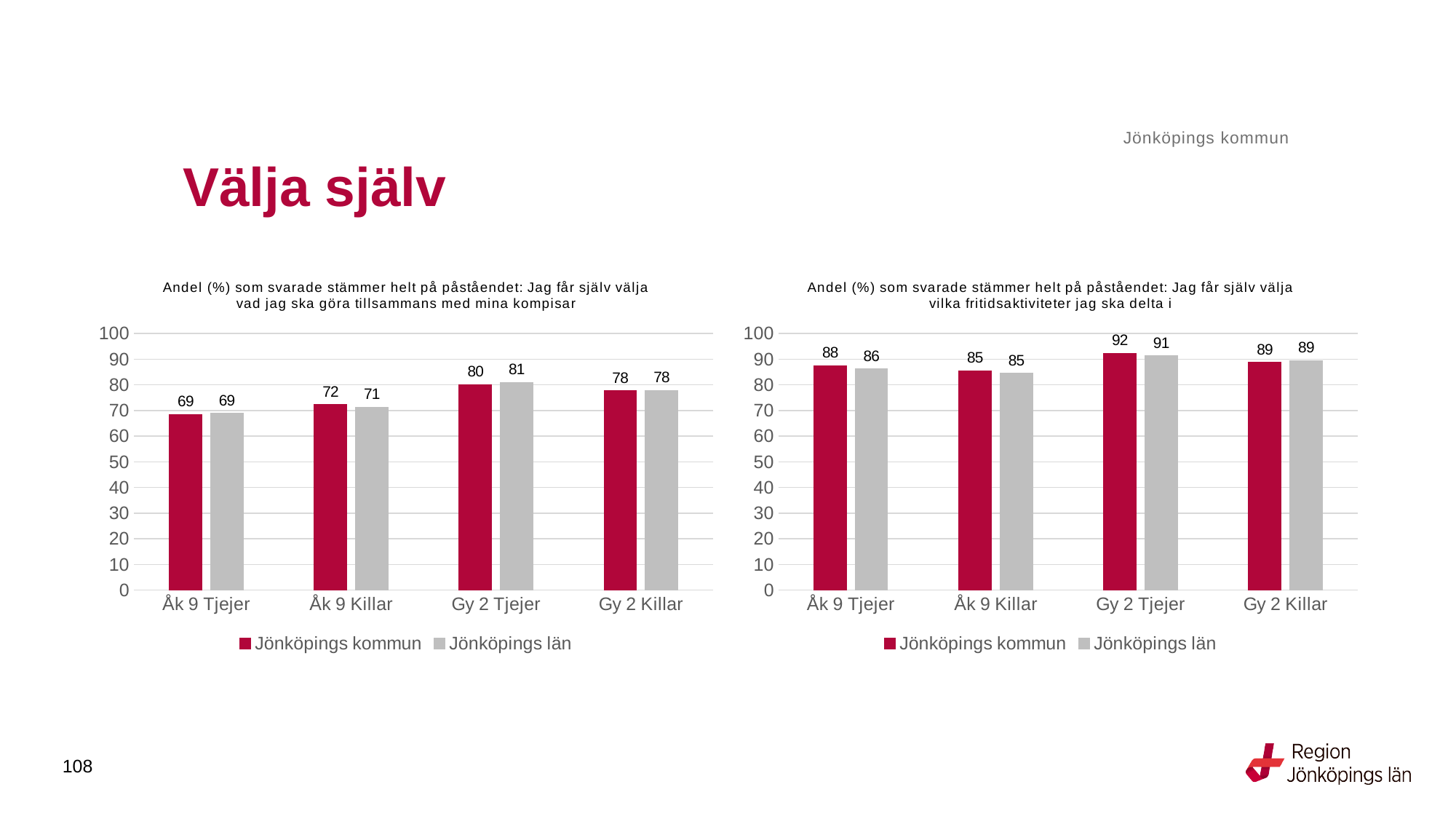
In the left chart, is the value for Jönköpings län for Åk 9 Tjejer greater or less than 80? less In the right chart (about choosing leisure activities), what is the value for Jönköpings län for Gy 2 Tjejer? 91 In the left chart, which colour represents Jönköpings kommun? red In the right chart, which category has the lowest value for Jönköpings län? Åk 9 Killar What kind of chart is the left chart? bar chart In the left chart, which category has the highest value for Jönköpings kommun? Gy 2 Tjejer In the right chart, which is larger for Gy 2 Tjejer: Jönköpings kommun or Jönköpings län? Jönköpings kommun In the right chart, what is the difference between the Jönköpings kommun and Jönköpings län values for Åk 9 Tjejer? 2 In the left chart (about choosing what to do with friends), what is the value for Jönköpings kommun for Åk 9 Killar? 72 In the left chart, what is the difference between the Jönköpings kommun values for Gy 2 Tjejer and Åk 9 Tjejer? 11 How many categories are shown on the x axis of the right chart? 4 How many series does the legend of the left chart list? 2